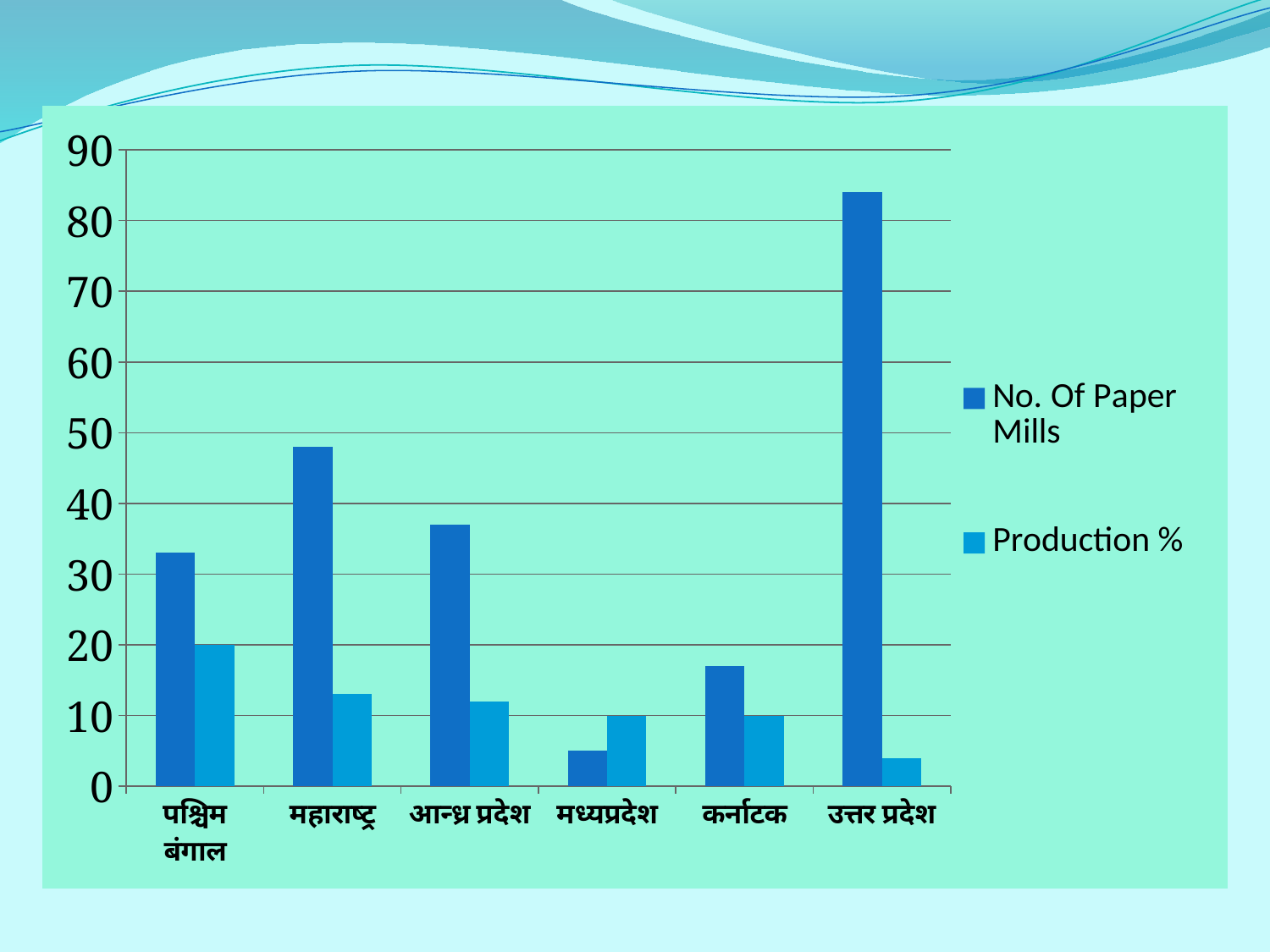
What kind of chart is shown on the slide? Bar chart How many series does the legend list? 2 Which state has the highest Production %? पश्चिम बंगाल What are the two entries listed in the legend? No. Of Paper Mills and Production % Is the No. Of Paper Mills value for उत्तर प्रदेश greater or less than 80? greater How many categories (states) are shown on the x axis? 6 Which has more paper mills, महाराष्ट्र or आन्ध्र प्रदेश? महाराष्ट्र Which state has the lowest Production %? उत्तर प्रदेश Which state has the lowest value for No. Of Paper Mills? मध्यप्रदेश Is the No. Of Paper Mills value for महाराष्ट्र greater or less than 50? less Which state has the highest value for No. Of Paper Mills? उत्तर प्रदेश What is the Production % value for पश्चिम बंगाल? 20